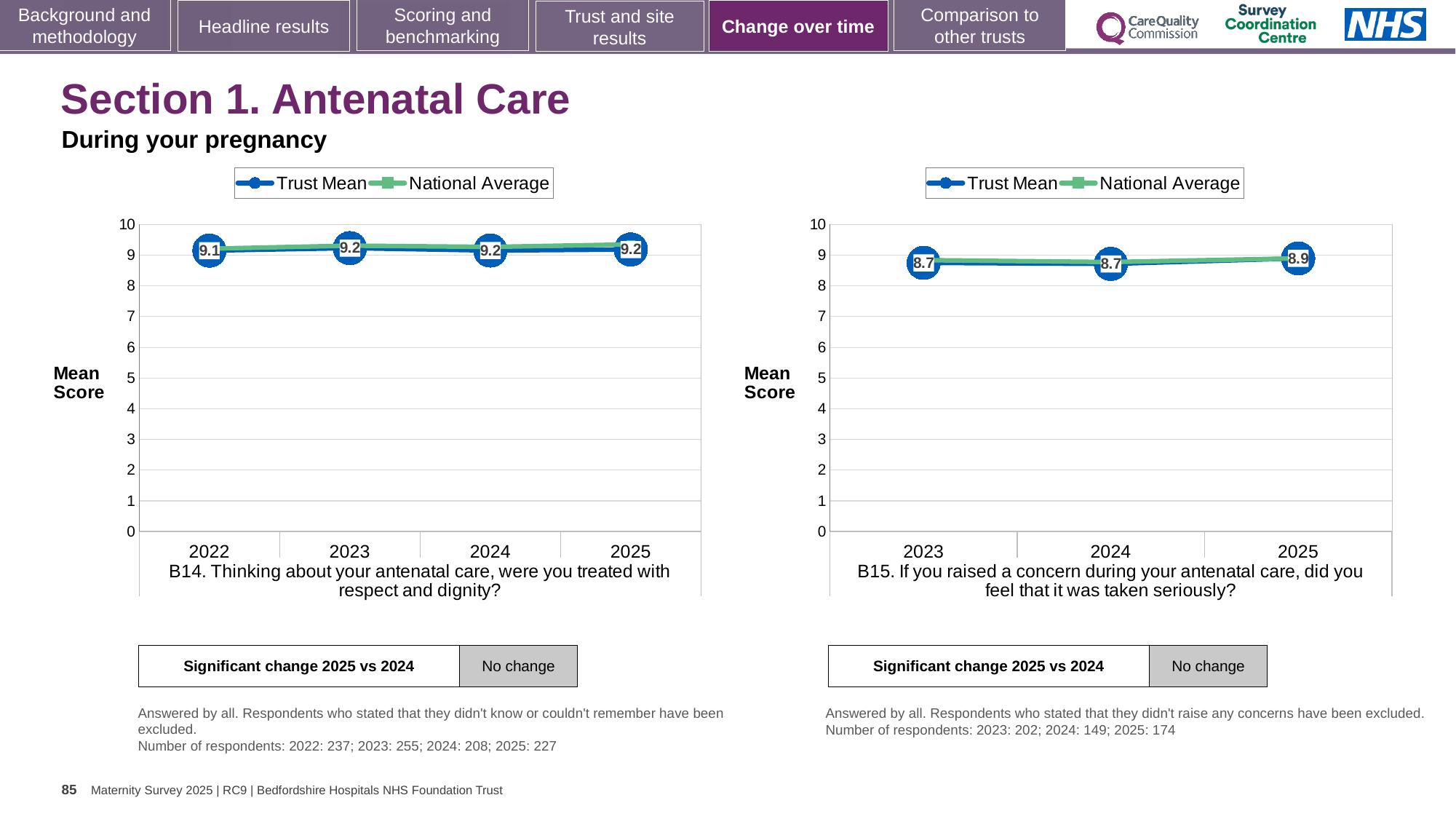
In the B14 chart (left), what is the Trust Mean for 2025? 9.2 In the B15 chart (right), what is the Trust Mean for 2025? 8.9 In the B14 chart (left), what is the difference between the Trust Mean for 2023 and the Trust Mean for 2022? 0.1 How many years are shown on the x axis of the B14 chart (left)? 4 In the B15 chart (right), is the Trust Mean for 2024 greater or less than 8? greater What kind of chart is the B15 chart (right)? Line chart In the B15 chart (right), what is the Trust Mean for 2023? 8.7 In the B15 chart (right), which year has the higher Trust Mean, 2024 or 2025? 2025 In the B14 chart (left), what is the Trust Mean for 2022? 9.1 How many series does the legend of the B14 chart (left) list? 2 In the B15 chart (right), what is the difference between the Trust Mean for 2025 and the Trust Mean for 2024? 0.2 How many years are shown on the x axis of the B15 chart (right)? 3